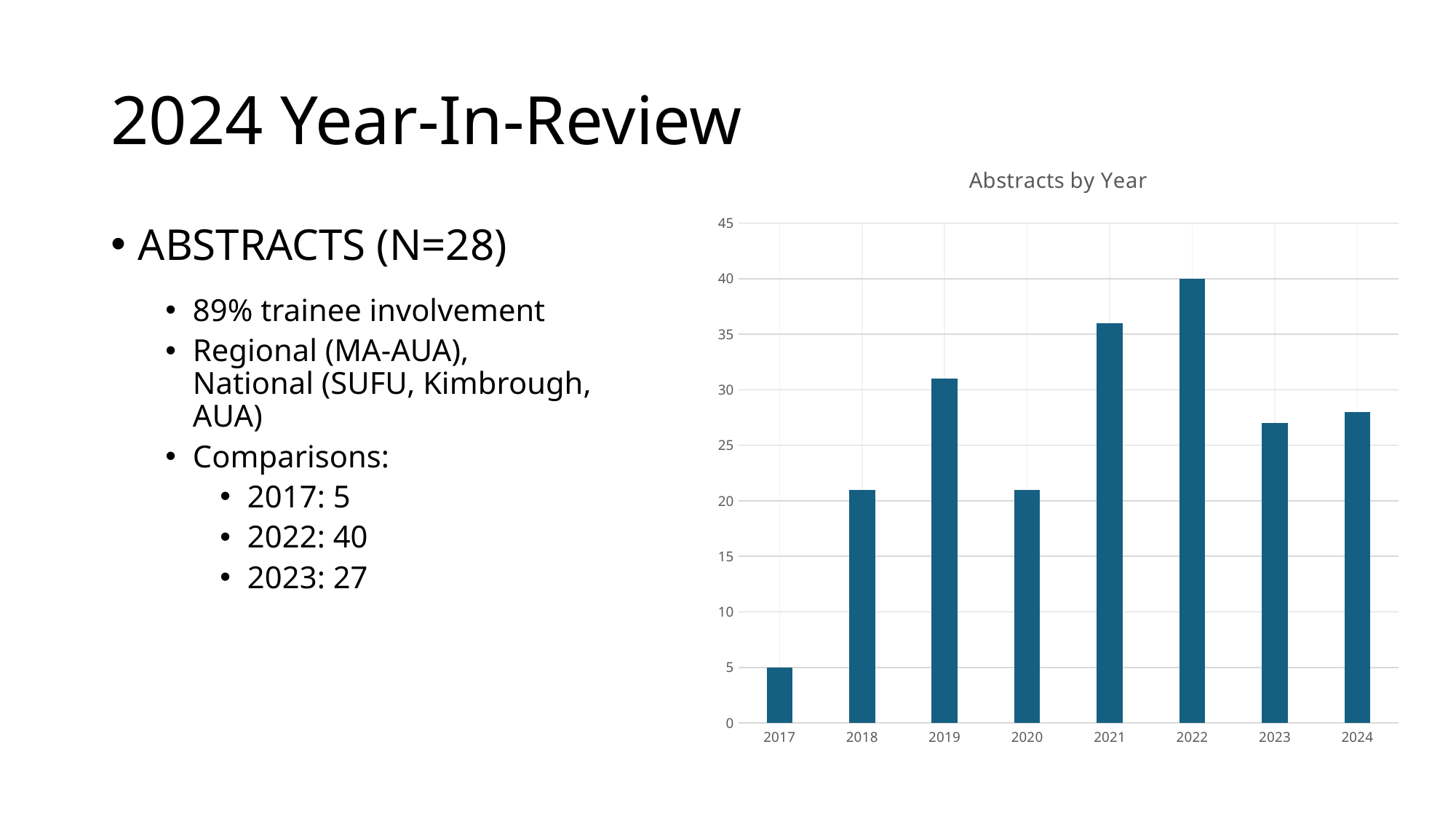
Which year has the lowest number of abstracts? 2017 How many abstracts were there in 2017? 5 How many years are shown on the x axis of the chart? 8 Is the value for 2021 greater or less than 35? greater Which year has the highest number of abstracts? 2022 How many abstracts were there in 2023? 27 Which year has more abstracts, 2021 or 2023? 2021 Is the value for 2018 greater or less than 20? greater What type of chart is shown on the slide? bar chart How many abstracts were there in 2022? 40 What is the difference between the number of abstracts in 2022 and in 2023? 13 What is the title of the chart? Abstracts by Year